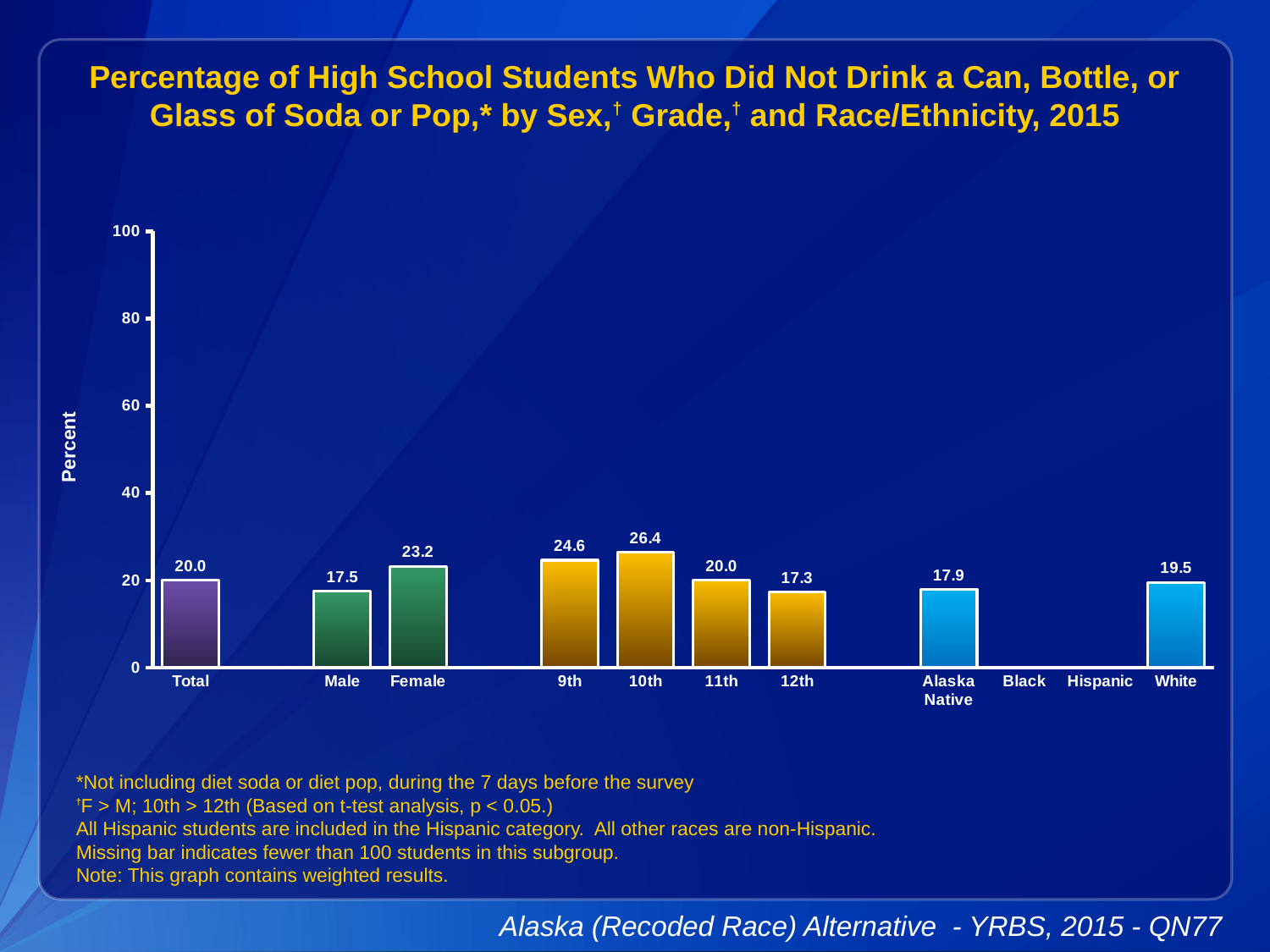
What is the difference between the Female and Male values? 5.7 What is the value for Total? 20.0 Is the value for White greater or less than 40? less How many bars are plotted on the chart? 9 Which grade has the lowest value? 12th What is the value for 10th grade? 26.4 Which category has the highest value? 10th What is the value for Female? 23.2 Which is larger, the value for 9th grade or the value for 11th grade? 9th Which race/ethnicity categories have no bar shown? Black and Hispanic What is the value for Alaska Native? 17.9 What kind of chart is shown? bar chart